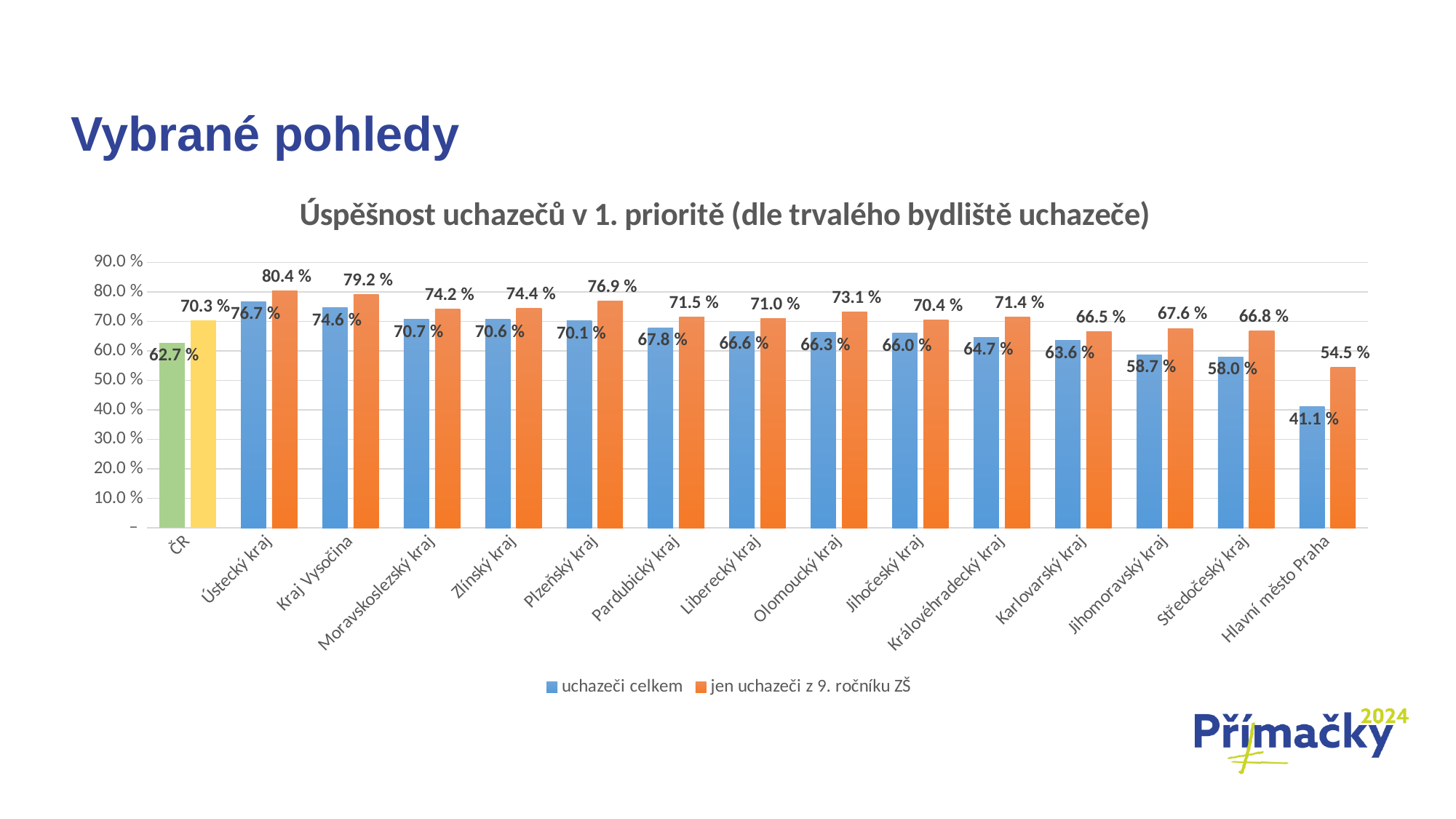
Which category has the highest value in the 'jen uchazeči z 9. ročníku ZŠ' series? Ústecký kraj What kind of chart is shown on the slide? Bar chart How many series does the legend list? 2 How many categories are shown on the x axis? 15 What is the value for Hlavní město Praha in the 'uchazeči celkem' series? 41.1 % What is the value for Ústecký kraj in the 'jen uchazeči z 9. ročníku ZŠ' series? 80.4 % Which is larger: the 'uchazeči celkem' value for Kraj Vysočina or for Jihomoravský kraj? Kraj Vysočina What is the title of the chart? Úspěšnost uchazečů v 1. prioritě (dle trvalého bydliště uchazeče) What is the difference between the two series for Hlavní město Praha? 13.4 % Which category has the lowest value in the 'uchazeči celkem' series? Hlavní město Praha What is the difference between the 'jen uchazeči z 9. ročníku ZŠ' and 'uchazeči celkem' values for Ústecký kraj? 3.7 % What is the value for ČR in the 'uchazeči celkem' series? 62.7 %